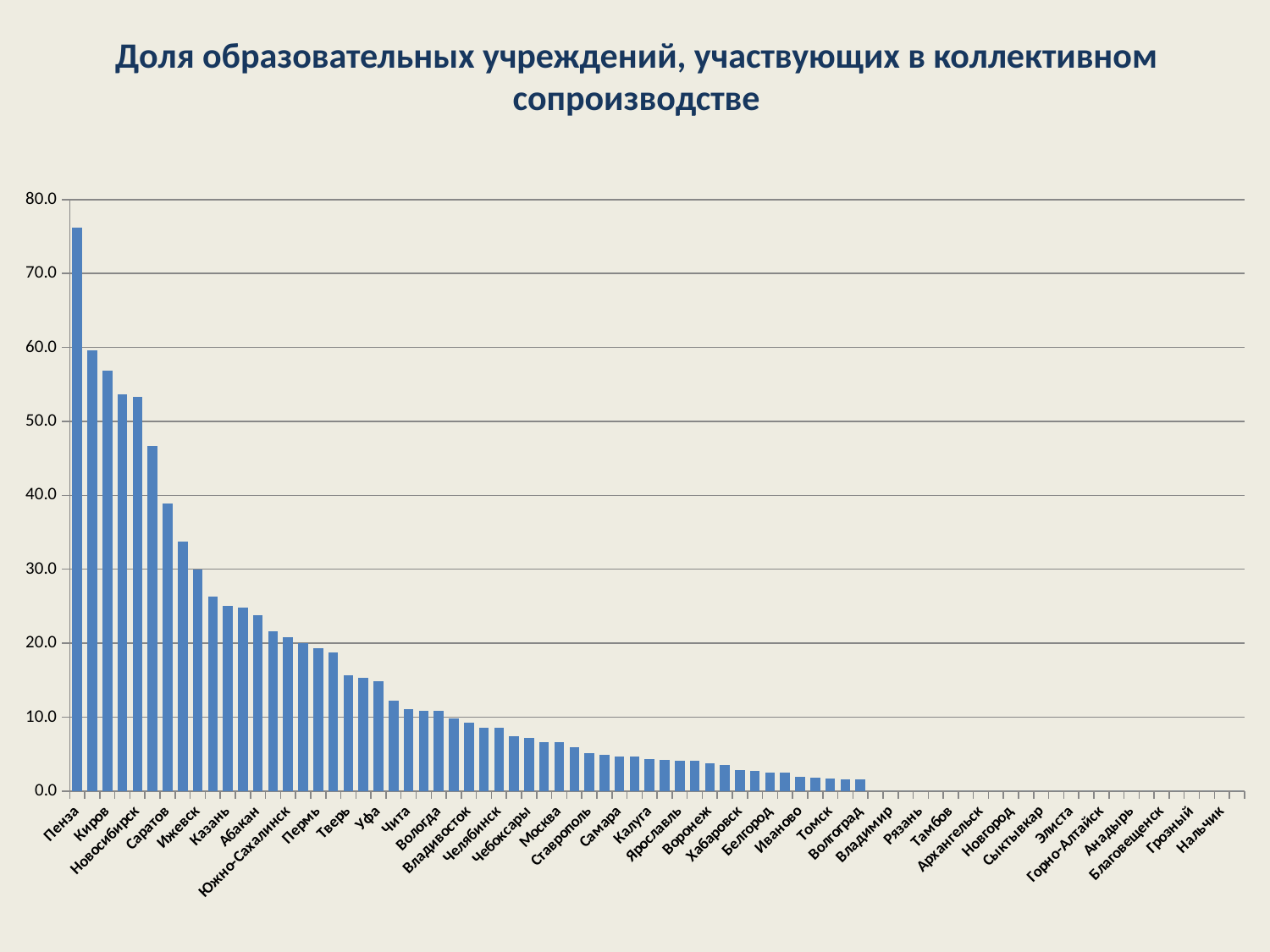
Which has the larger value, Саратов or Казань? Саратов Is the value for Пенза greater or less than 70? greater Is the value for Киров greater or less than 50? greater Is the value for Новосибирск greater or less than 60? less What is the title of the chart? Доля образовательных учреждений, участвующих в коллективном сопроизводстве Which has the larger value, Пенза or Киров? Пенза What kind of chart is shown on the slide? bar chart Which city has the highest value in the chart? Пенза Do the values rise or fall moving from left to right along the x axis? fall